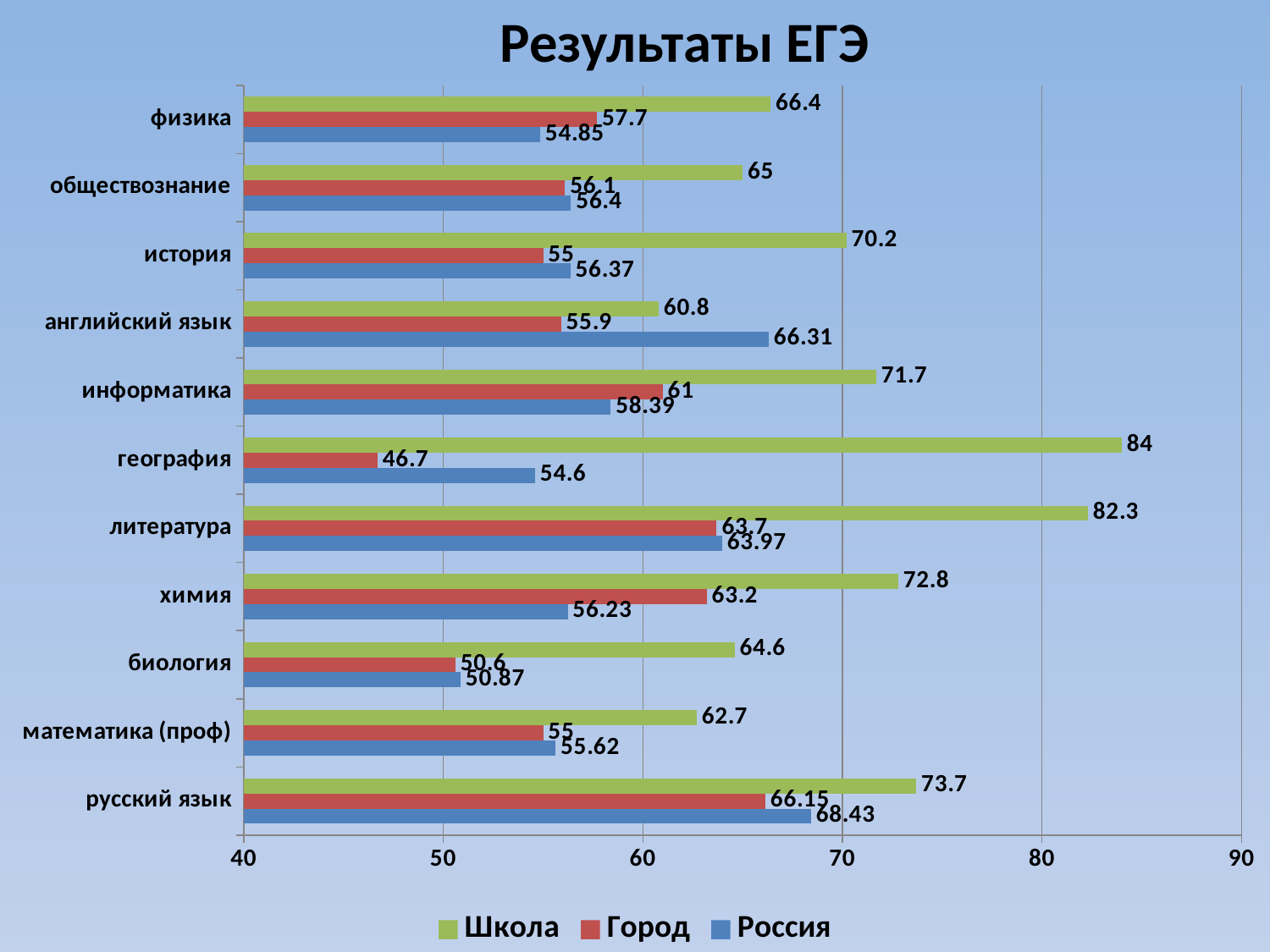
What is the difference between the Школа and Город values for география? 37.3 What is the Россия value for русский язык? 68.43 Is the Школа value for литература greater or less than 80? greater How many subjects are shown on the chart? 11 For английский язык, which is larger: the Школа value or the Россия value? Россия What kind of chart is shown on the slide? bar chart How many series does the legend list? 3 What is the Город value for информатика? 61 What is the title of the chart? Результаты ЕГЭ Which subject has the lowest Город value? география Which subject has the highest Школа value? география What is the Школа value for география? 84